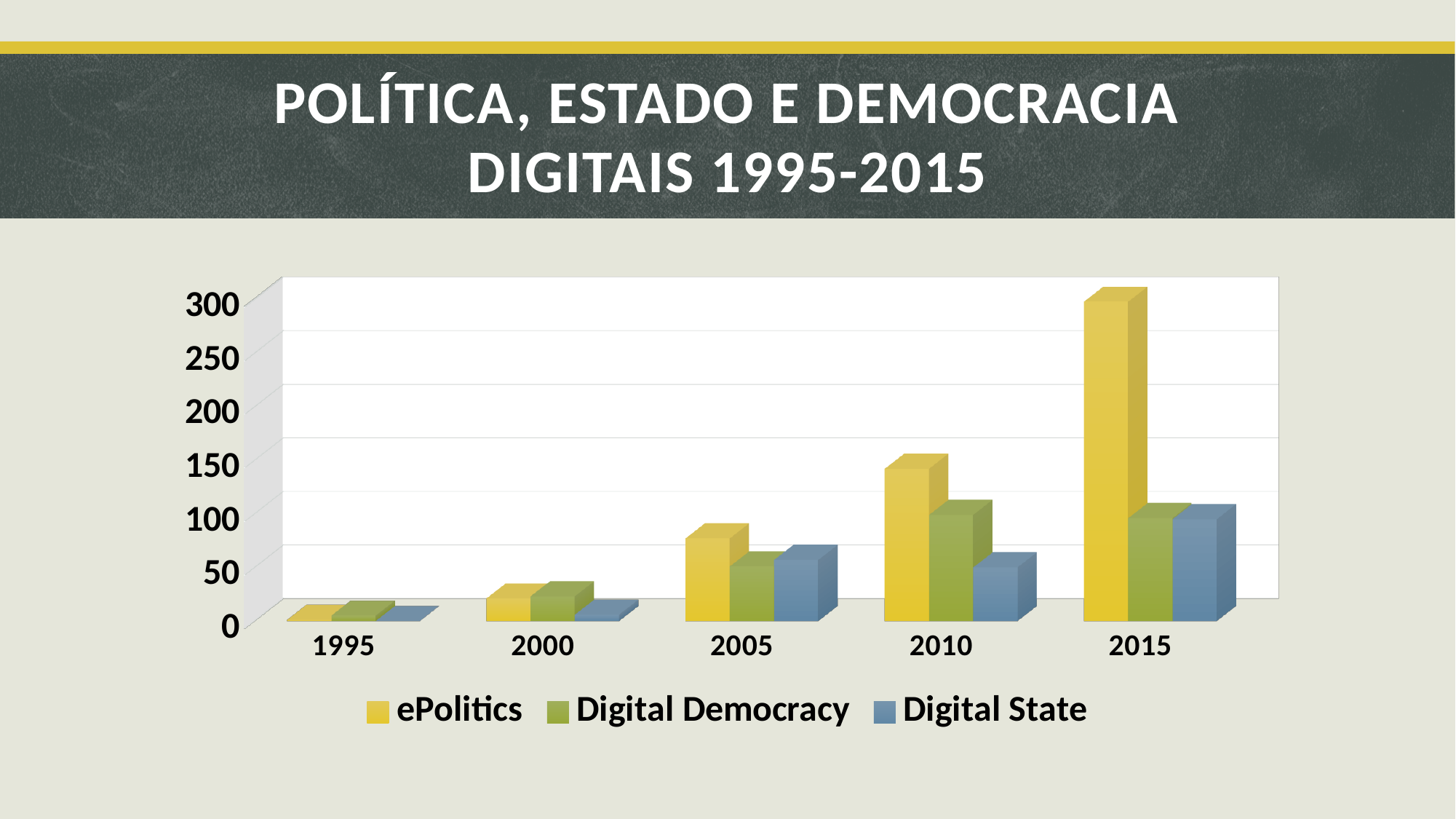
In 2010, which is larger: ePolitics or Digital State? ePolitics How many series does the legend list? 3 Is the value for ePolitics in 2015 greater or less than 250? greater In which year is the ePolitics bar lowest? 1995 Is the value for ePolitics in 2010 greater or less than 100? greater In which year is the ePolitics bar highest? 2015 Do the ePolitics values rise or fall from 1995 to 2015? rise Is the value for Digital State in 2010 greater or less than 100? less What is the title of the slide containing the chart? POLÍTICA, ESTADO E DEMOCRACIA DIGITAIS 1995-2015 How many years are shown on the x axis? 5 What kind of chart is shown on the slide? bar chart Which series is shown in yellow in the legend? ePolitics